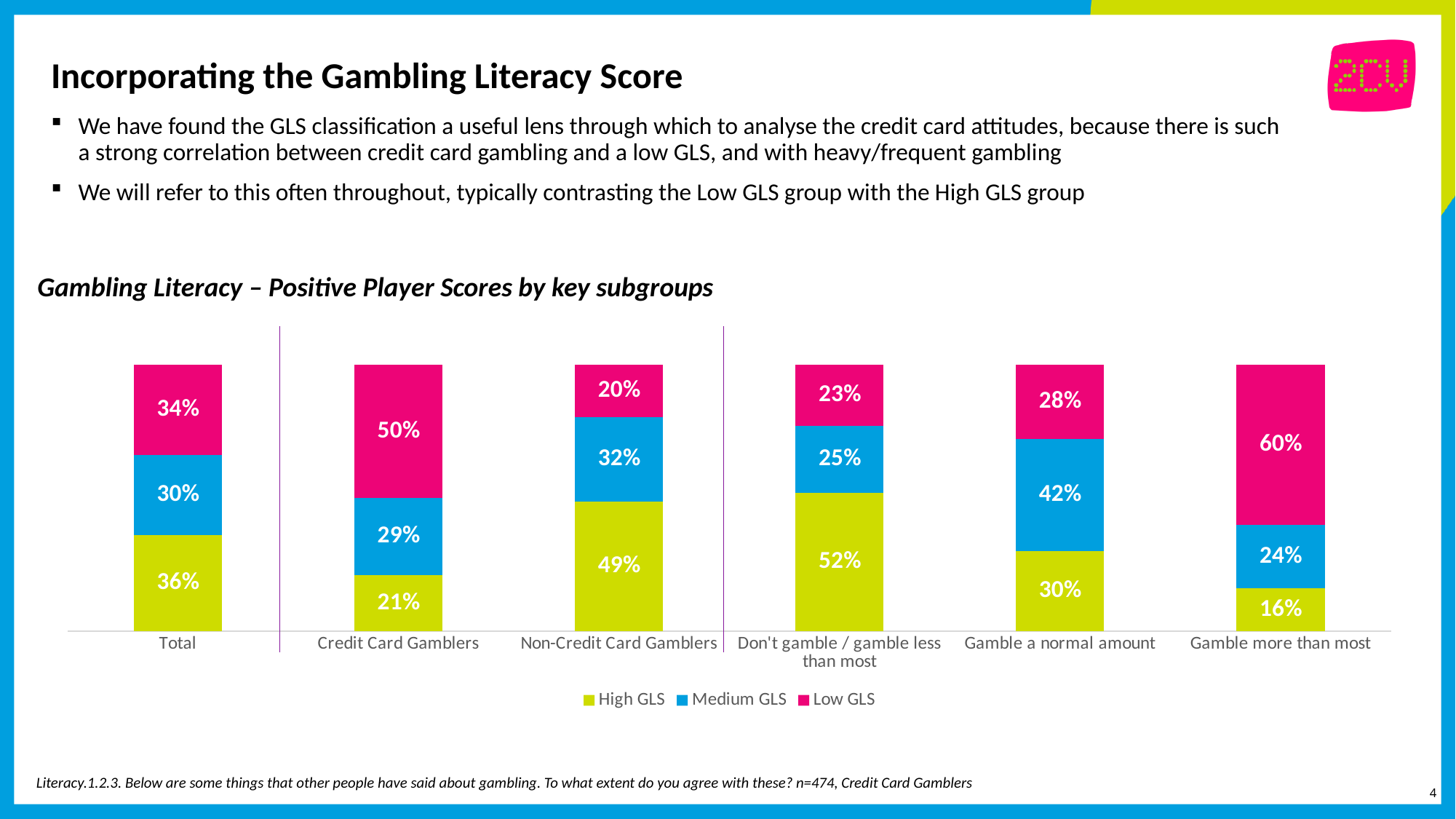
What kind of chart is shown on the slide? Stacked bar chart Which subgroup has the highest Low GLS share? Gamble more than most What is the Low GLS value for Credit Card Gamblers? 50% What is the High GLS value for Non-Credit Card Gamblers? 49% Which subgroup has the lowest High GLS share? Gamble more than most How many subgroups (bars) are shown on the chart? 6 What is the Medium GLS value for the 'Don't gamble / gamble less than most' group? 25% Which colour represents Low GLS in the legend? Pink How many series does the legend list? 3 What is the difference in High GLS share between Non-Credit Card Gamblers and Credit Card Gamblers? 28 percentage points What is the total of the three segments in the 'Total' bar? 100% Which has a larger Medium GLS share: 'Gamble a normal amount' or 'Total'? Gamble a normal amount